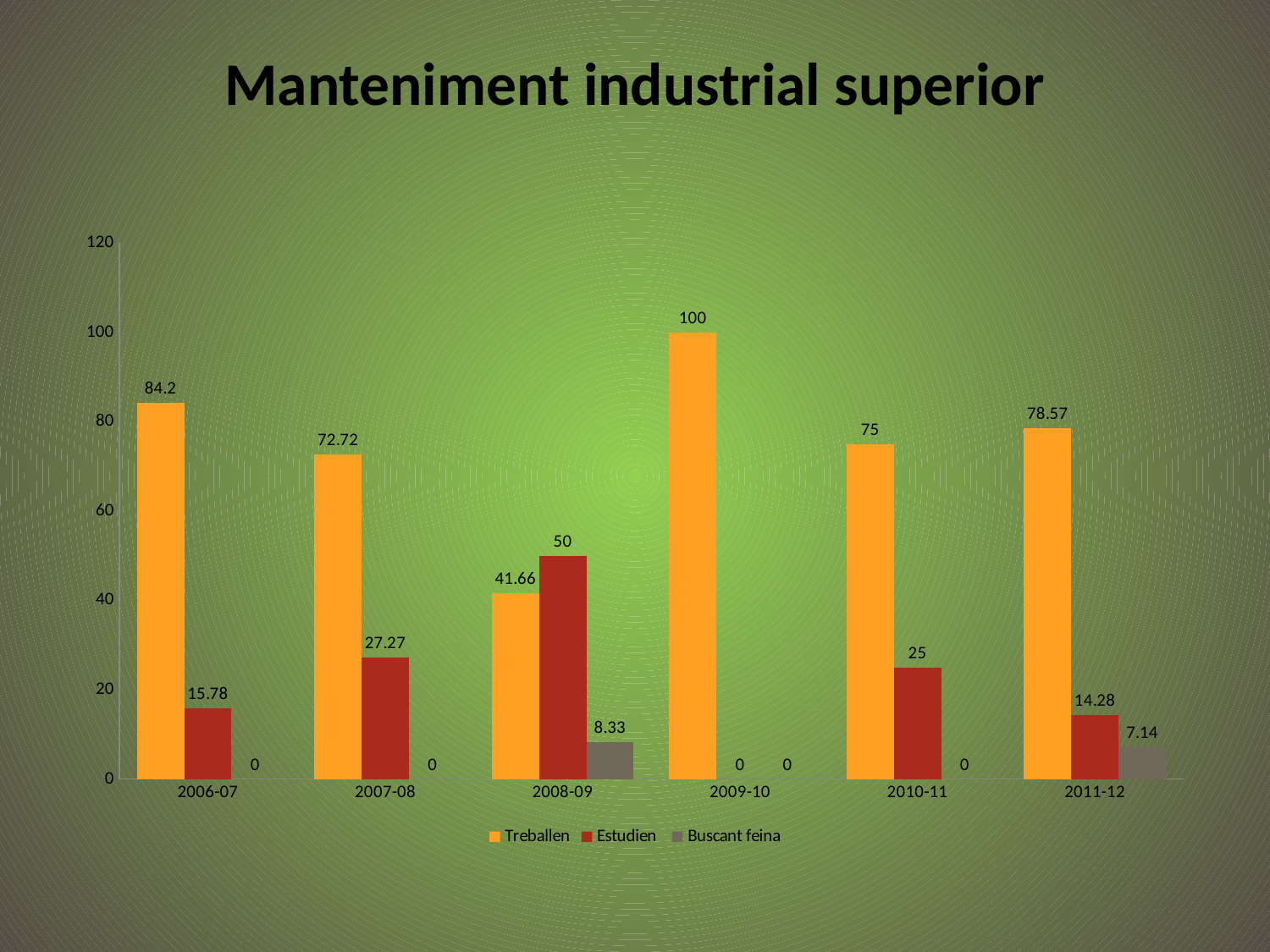
In 2008-09, which is larger: Treballen or Estudien? Estudien How many years are shown on the x axis? 6 What is the Buscant feina value for 2011-12? 7.14 Which year has the lowest Treballen value? 2008-09 What is the Estudien value for 2007-08? 27.27 Which year has the highest Treballen value? 2009-10 How many series does the legend list? 3 What is the difference between the Treballen and Estudien values in 2006-07? 68.42 What is the Treballen value for 2009-10? 100 What is the title of the chart? Manteniment industrial superior Is the Treballen value for 2011-12 greater or less than 80? less What kind of chart is shown on the slide? bar chart